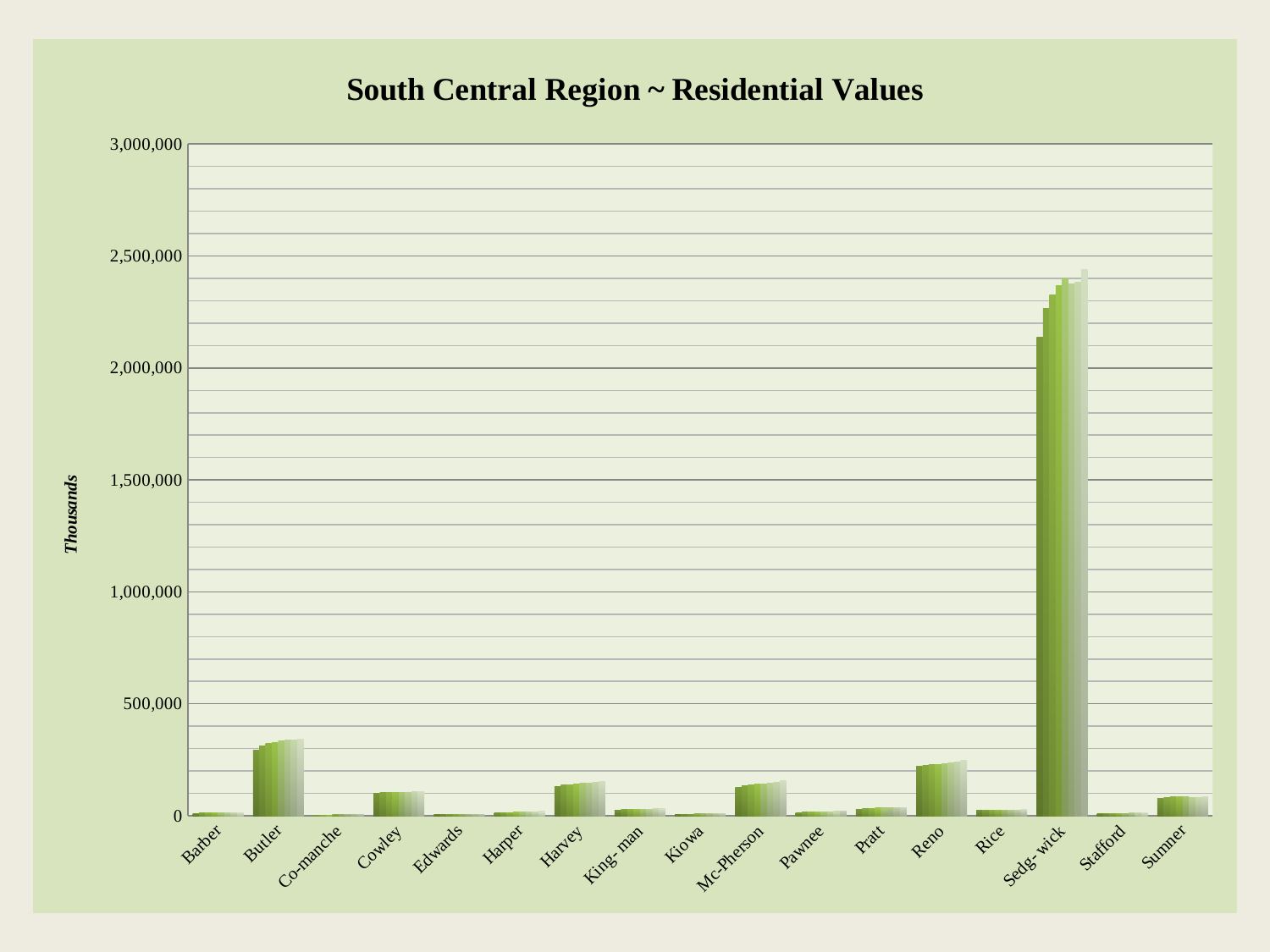
Which county has larger residential values, Sedg-wick or Butler? Sedg-wick Which county has larger residential values, Butler or Reno? Butler Which county has the highest residential values in the chart? Sedg-wick What kind of chart is shown on the slide? Bar chart Which county has larger residential values, Reno or Harvey? Reno Are the values for Sedg-wick greater or less than 2,000,000? greater How many counties (categories) are shown along the x axis? 17 What label is shown on the vertical axis of the chart? Thousands What is the title of the chart? South Central Region ~ Residential Values Are the values for Reno greater or less than 500,000? less Are the values for Butler greater or less than 500,000? less